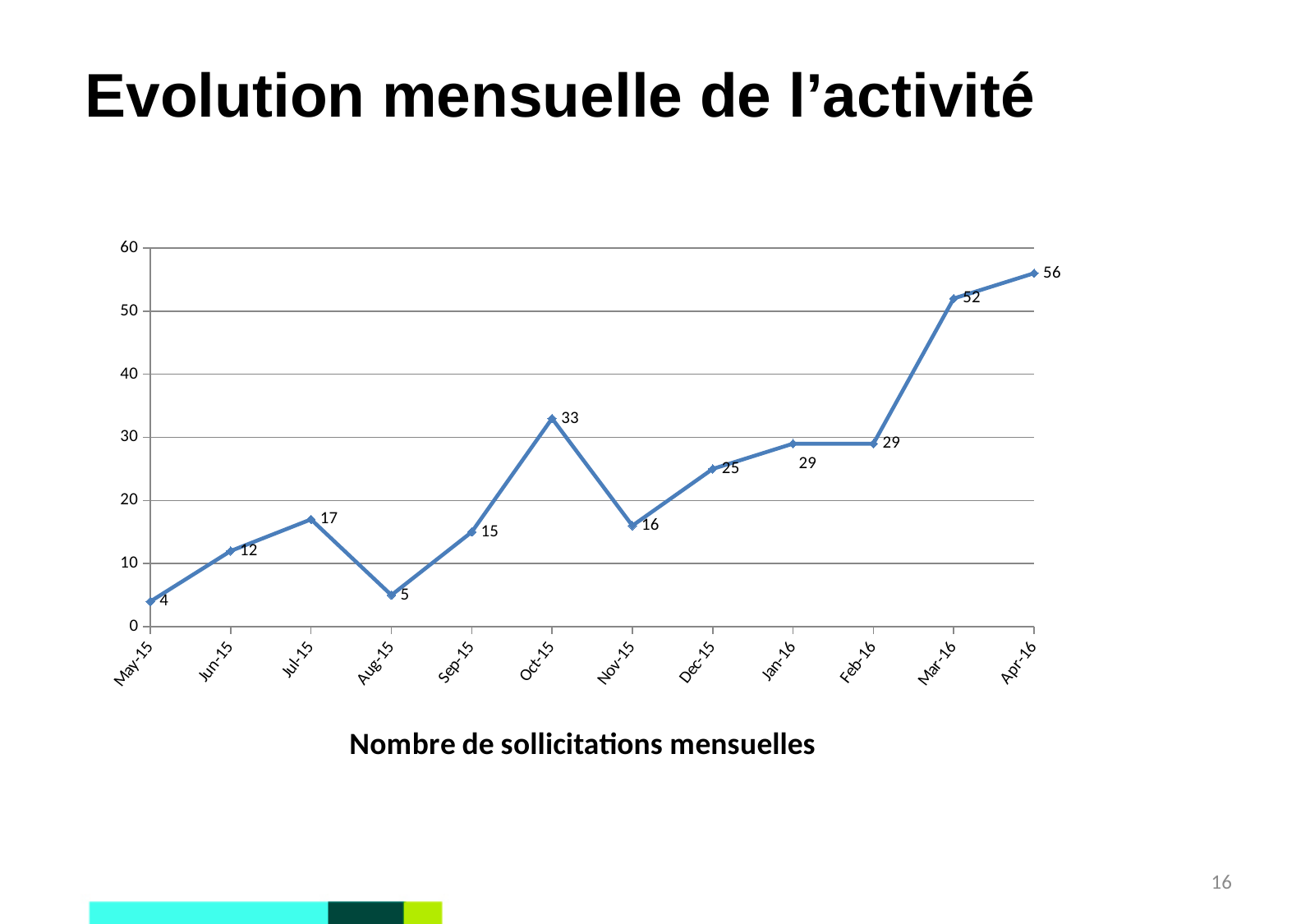
What is the value for Mar-16? 52 What kind of chart is shown on the slide? line chart What is the difference between the values for Apr-16 and Mar-16? 4 How many months are plotted on the x axis? 12 What is the difference between the values for Oct-15 and Nov-15? 17 What is the title shown below the chart? Nombre de sollicitations mensuelles Which month has the highest value? Apr-16 What is the value for Aug-15? 5 Which month has the lowest value? May-15 What is the value for Oct-15? 33 Which is larger, the value for Jul-15 or the value for Sep-15? Jul-15 Is the value for Dec-15 greater or less than 20? greater